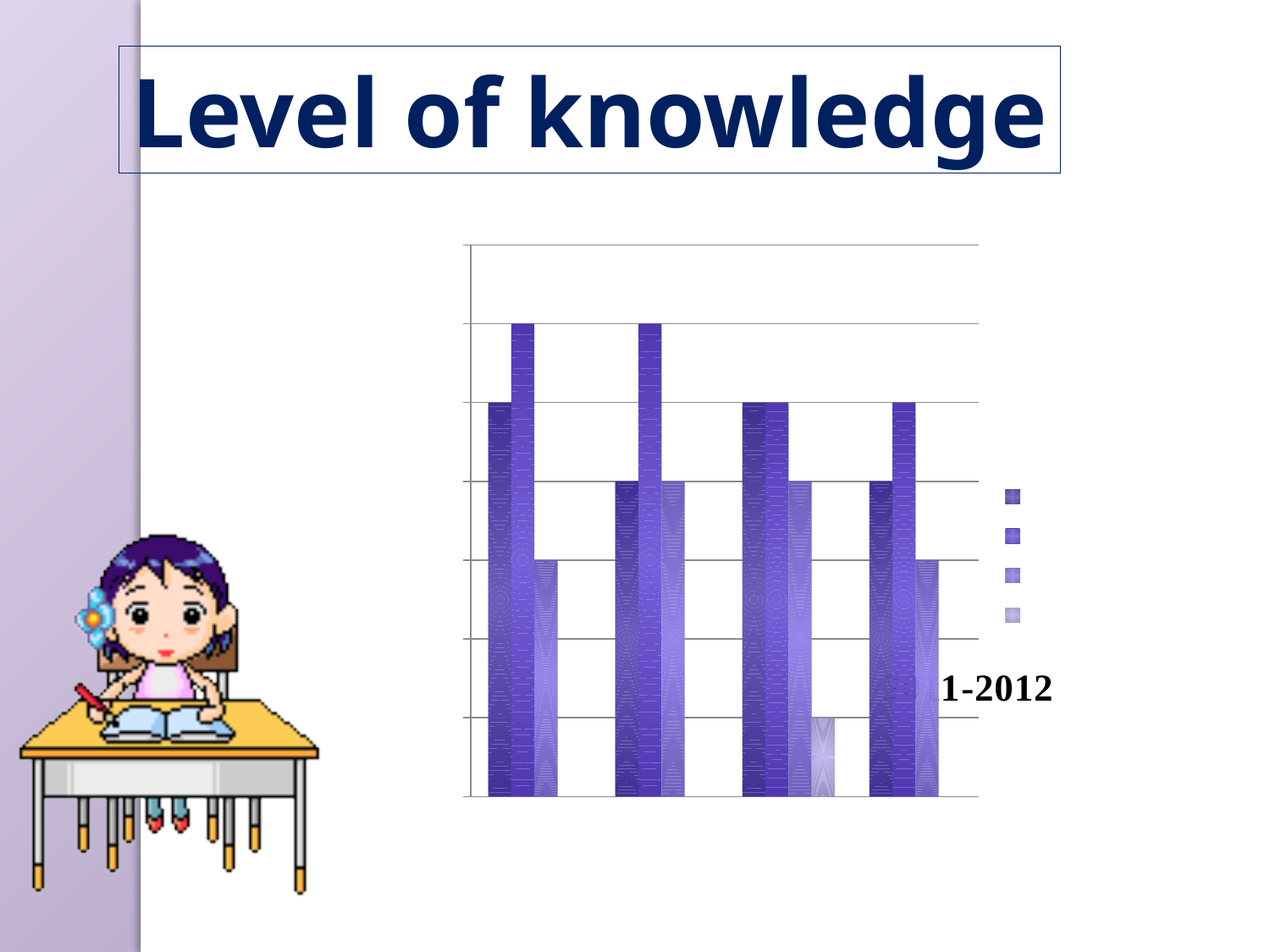
In the third group of bars from the left, is the third bar taller or shorter than the first bar? shorter How many groups of bars does the chart show? 4 In the leftmost group of bars, is the first bar taller or shorter than the second bar? shorter How many bars are in each group on the chart? 3 in the first, second and fourth groups; 4 in the third group What is the title shown above the chart on the slide? Level of knowledge Which group of bars contains the shortest bar on the chart: the first, second, third or fourth from the left? third How many entries (markers) does the chart's legend show? 4 Does the chart's vertical axis show any numeric tick labels? No What kind of chart is shown on the slide? bar chart